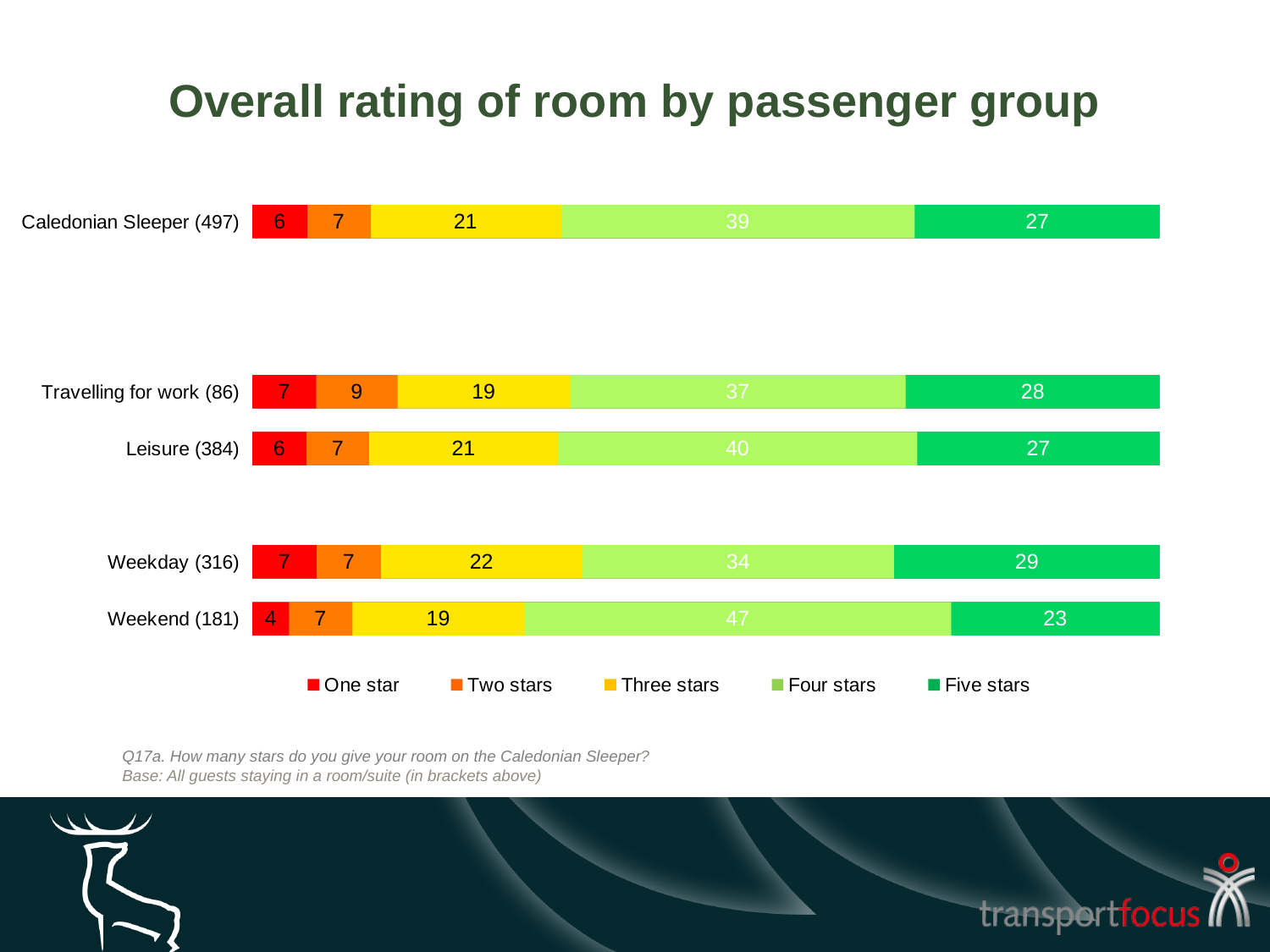
What kind of chart is shown on the slide? Stacked bar chart Which is larger, the Five stars value for Travelling for work (86) or for Leisure (384)? Travelling for work (86) How many passenger groups are shown in the chart? 5 What is the Four stars value for Weekend (181)? 47 Which passenger group has the lowest One star value? Weekend (181) What is the Three stars value for Caledonian Sleeper (497)? 21 What is the One star value for Travelling for work (86)? 7 What is the Five stars value for Weekday (316)? 29 How many series does the legend list? 5 What is the difference between the Four stars values for Weekend (181) and Weekday (316)? 13 Which passenger group has the highest Four stars value? Weekend (181) What is the total of the Four stars and Five stars values for Leisure (384)? 67